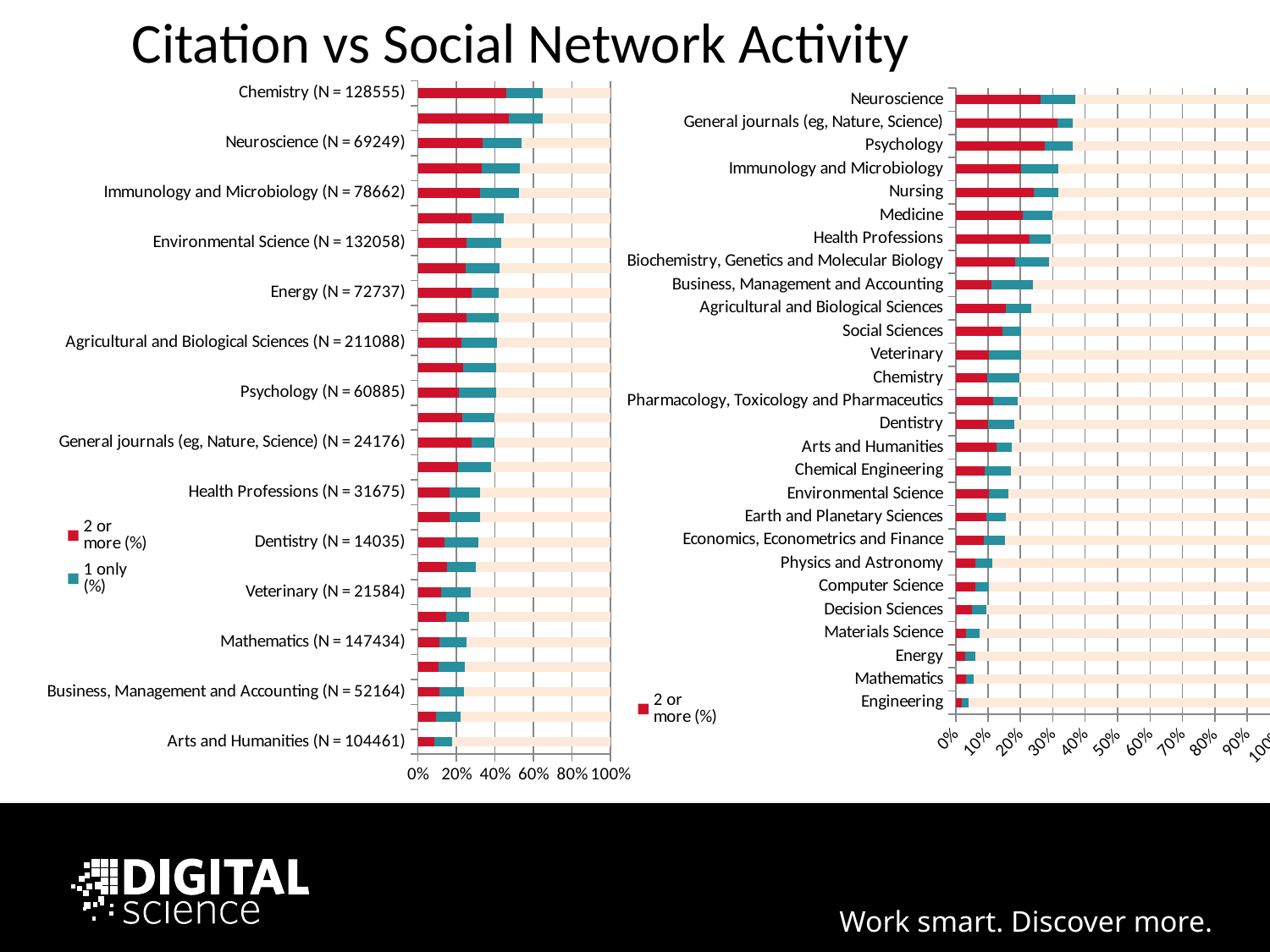
In the right chart, do the total bar lengths rise or fall going from the top category to the bottom category? fall How many series does the legend of the right chart list? 1 In the left chart, is the total bar for Chemistry (N = 128555) greater or less than 50%? greater In the left chart, which has the larger total bar: Chemistry (N = 128555) or Arts and Humanities (N = 104461)? Chemistry (N = 128555) In the right chart, is the total bar for Engineering greater or less than 10%? less In the right chart, which category has the highest total bar? Neuroscience In the right chart, which category has the lowest total bar? Engineering In the right chart, is the '2 or more (%)' value for Neuroscience greater or less than 20%? greater How many series does the legend of the left chart list? 2 What kind of chart is the chart on the left side of the slide? bar chart How many categories are plotted in the right chart? 27 What kind of chart is the chart on the right side of the slide? bar chart